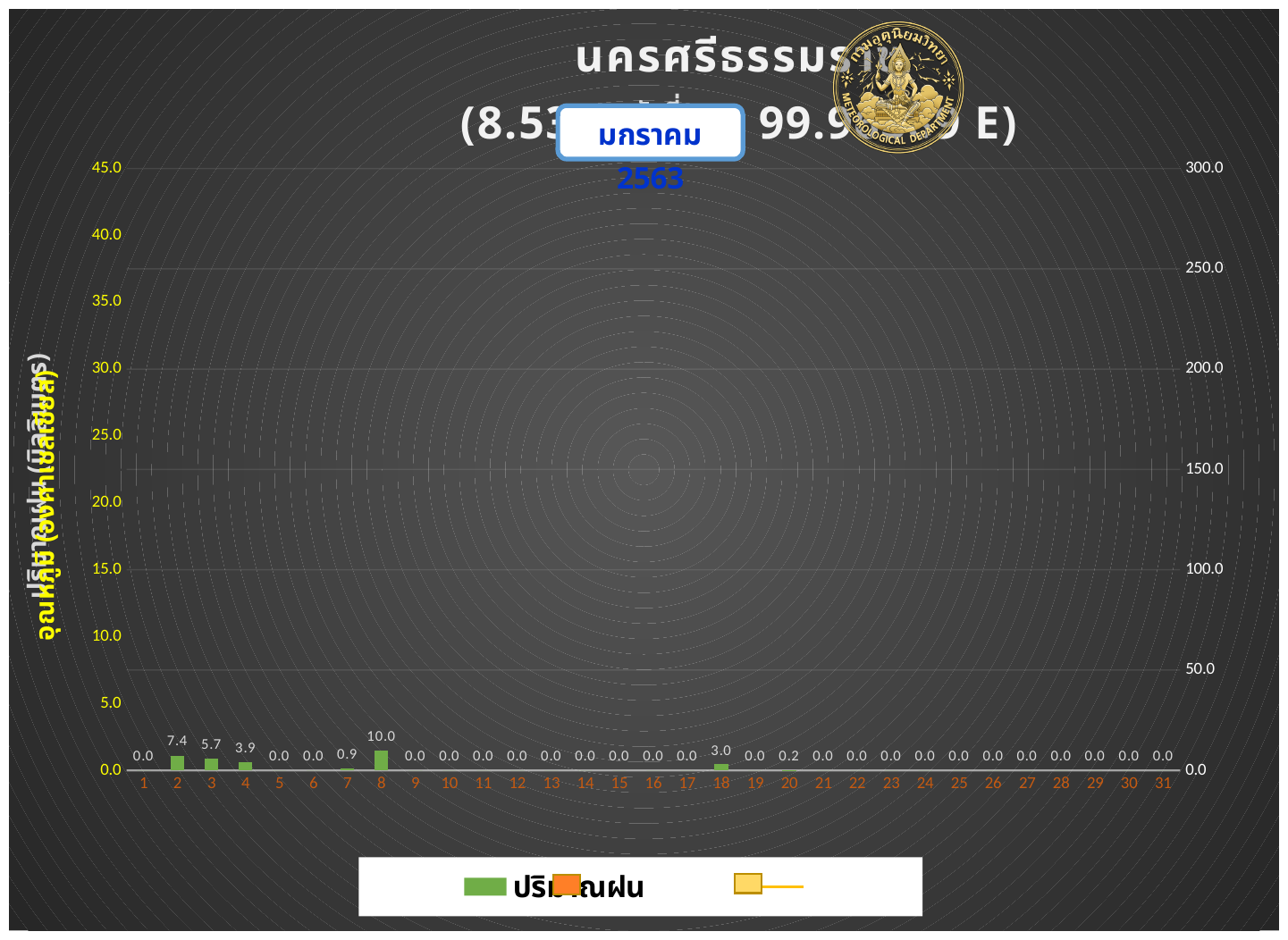
What kind of chart is shown on the slide? bar chart Which day has the highest bar value? 8 What is the value of the bar for day 20? 0.2 What is the value of the bar for day 8? 10.0 What is the difference between the values for day 2 and day 3? 1.7 What is the value of the bar for day 7? 0.9 What is the difference between the values for day 8 and day 4? 6.1 Which is larger, the value for day 3 or the value for day 4? day 3 Is the value for day 8 greater or less than 5.0? greater What is the value of the bar for day 18? 3.0 How many days (categories) are shown on the x axis? 31 What is the value of the bar for day 2? 7.4